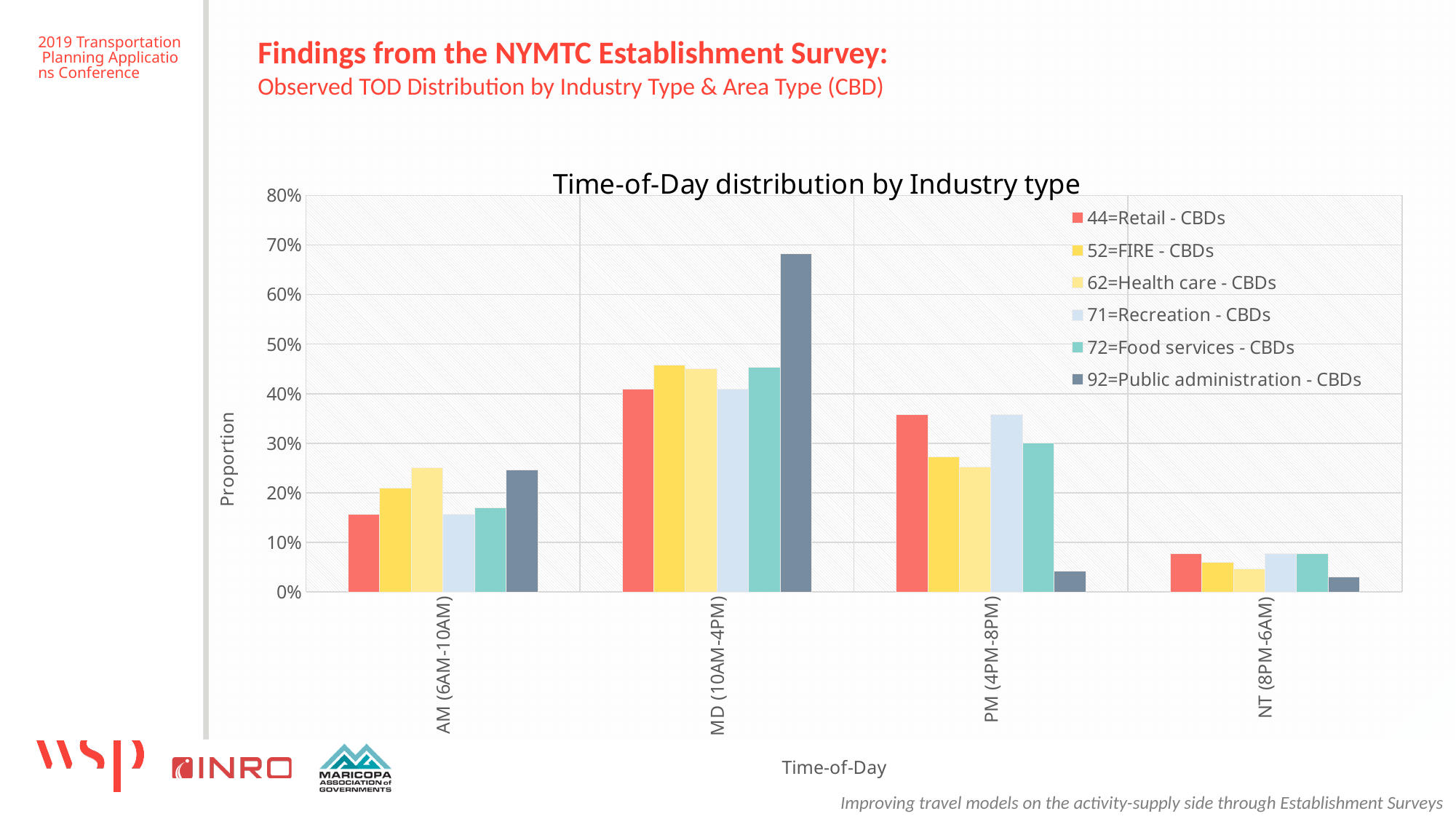
What is the label on the vertical axis of the chart? Proportion Which industry has the lowest proportion in the PM (4PM-8PM) period? 92=Public administration - CBDs Which industry has the highest proportion in the MD (10AM-4PM) period? 92=Public administration - CBDs In the AM (6AM-10AM) period, which is larger: Health care or Recreation? Health care What is the title of the chart? Time-of-Day distribution by Industry type How many series does the legend list? 6 How many time-of-day categories are shown on the x axis? 4 What kind of chart is shown on the slide? Bar chart Is the value for Retail in the MD (10AM-4PM) period greater or less than 50%? less Is the value for Public administration in the MD (10AM-4PM) period greater or less than 60%? greater In the PM (4PM-8PM) period, which is larger: Retail or FIRE? Retail Is the value for Health care in the AM (6AM-10AM) period greater or less than 20%? greater